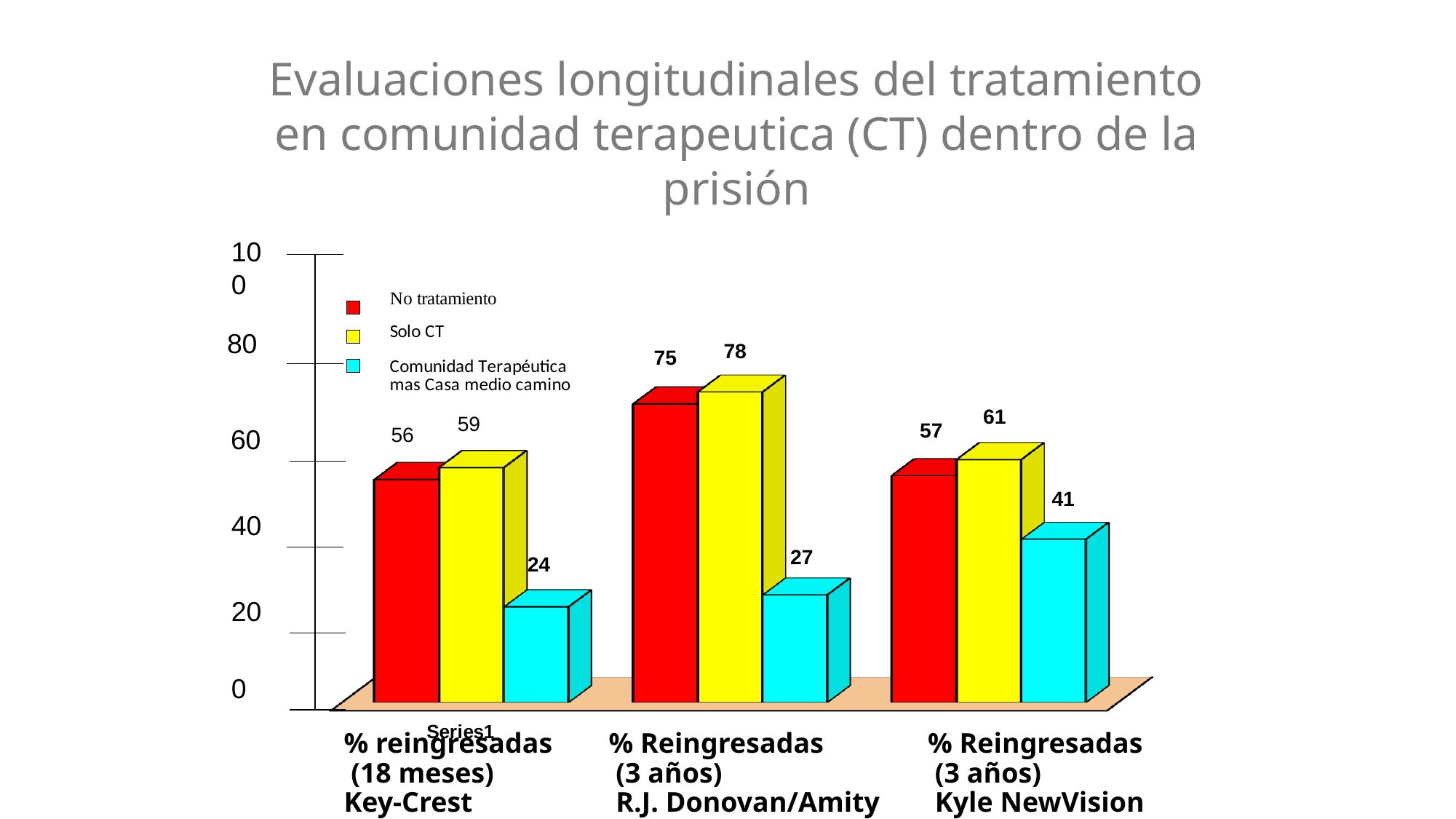
Which group has the lowest value for Comunidad Terapéutica mas Casa medio camino? Key-Crest (18 meses) Is the value for Solo CT in the Key-Crest (18 meses) group greater or less than 40? greater What is the value for No tratamiento in the Key-Crest (18 meses) group? 56 How many groups of bars are shown on the chart? 3 What is the value for Comunidad Terapéutica mas Casa medio camino in the Kyle NewVision (3 años) group? 41 Which group has the highest value for Solo CT? R.J. Donovan/Amity (3 años) In the Kyle NewVision (3 años) group, which is larger: No tratamiento or Solo CT? Solo CT What is the value for Solo CT in the R.J. Donovan/Amity (3 años) group? 78 What is the difference between the No tratamiento and Comunidad Terapéutica mas Casa medio camino values in the R.J. Donovan/Amity (3 años) group? 48 How many series does the legend list? 3 What is the value for Comunidad Terapéutica mas Casa medio camino in the Key-Crest (18 meses) group? 24 What kind of chart is shown on the slide? Bar chart